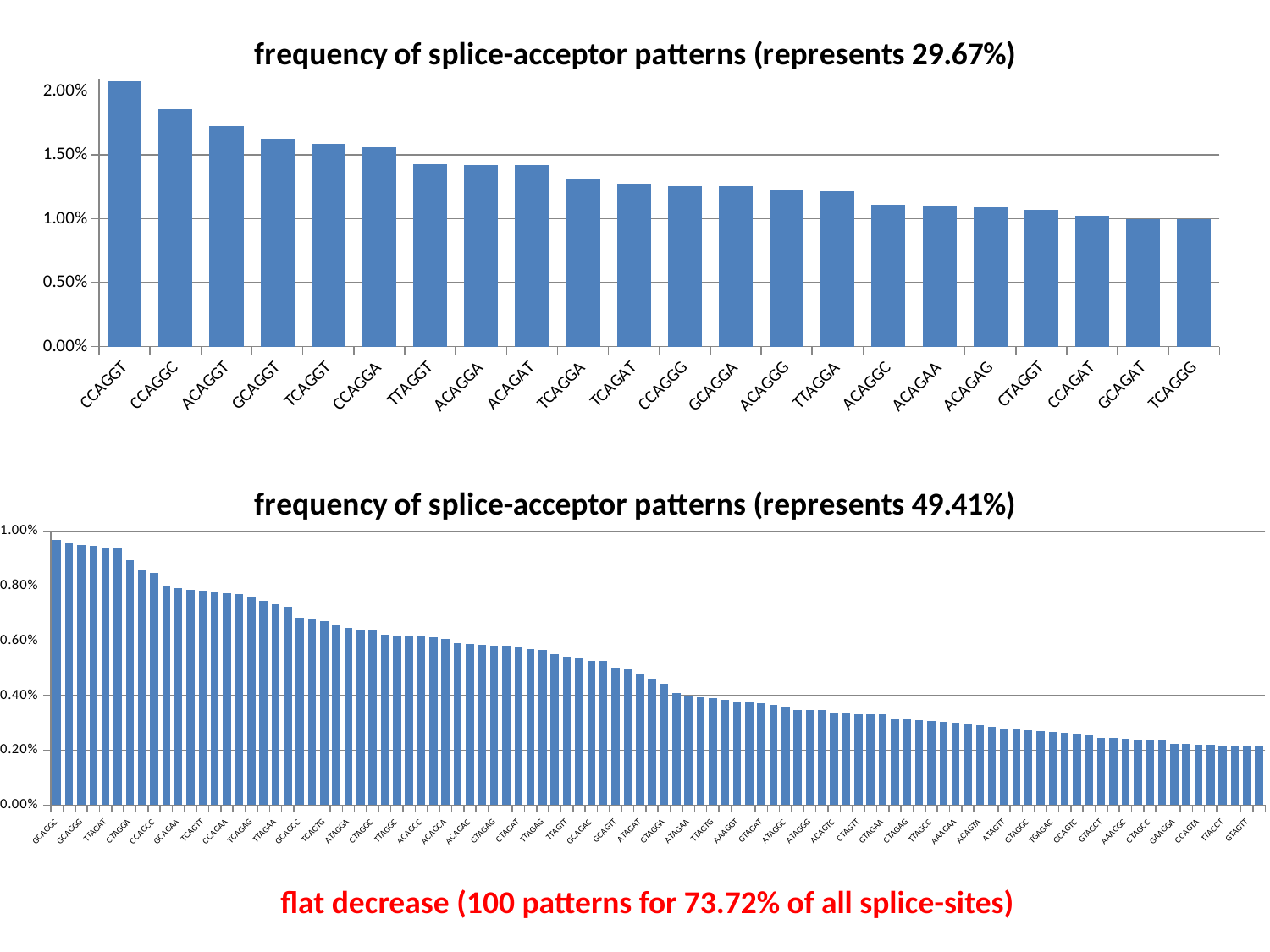
In the top chart, is the value for CCAGGC greater or less than 2.00%? less In the top chart, is the value for TCAGGA greater or less than 1.50%? less In the top chart, is the value for ACAGGC greater or less than 1.00%? greater In the top chart, which splice-acceptor pattern has the highest frequency? CCAGGT What type of chart is the top chart? bar chart In the top chart, which has the higher frequency, ACAGGT or TCAGGT? ACAGGT How many splice-acceptor patterns are shown in the top chart? 22 According to the red caption below the bottom chart, what percentage of all splice-sites do the 100 patterns account for? 73.72% What is the title of the bottom chart? frequency of splice-acceptor patterns (represents 49.41%) In the bottom chart, do the values rise or fall from left to right? fall